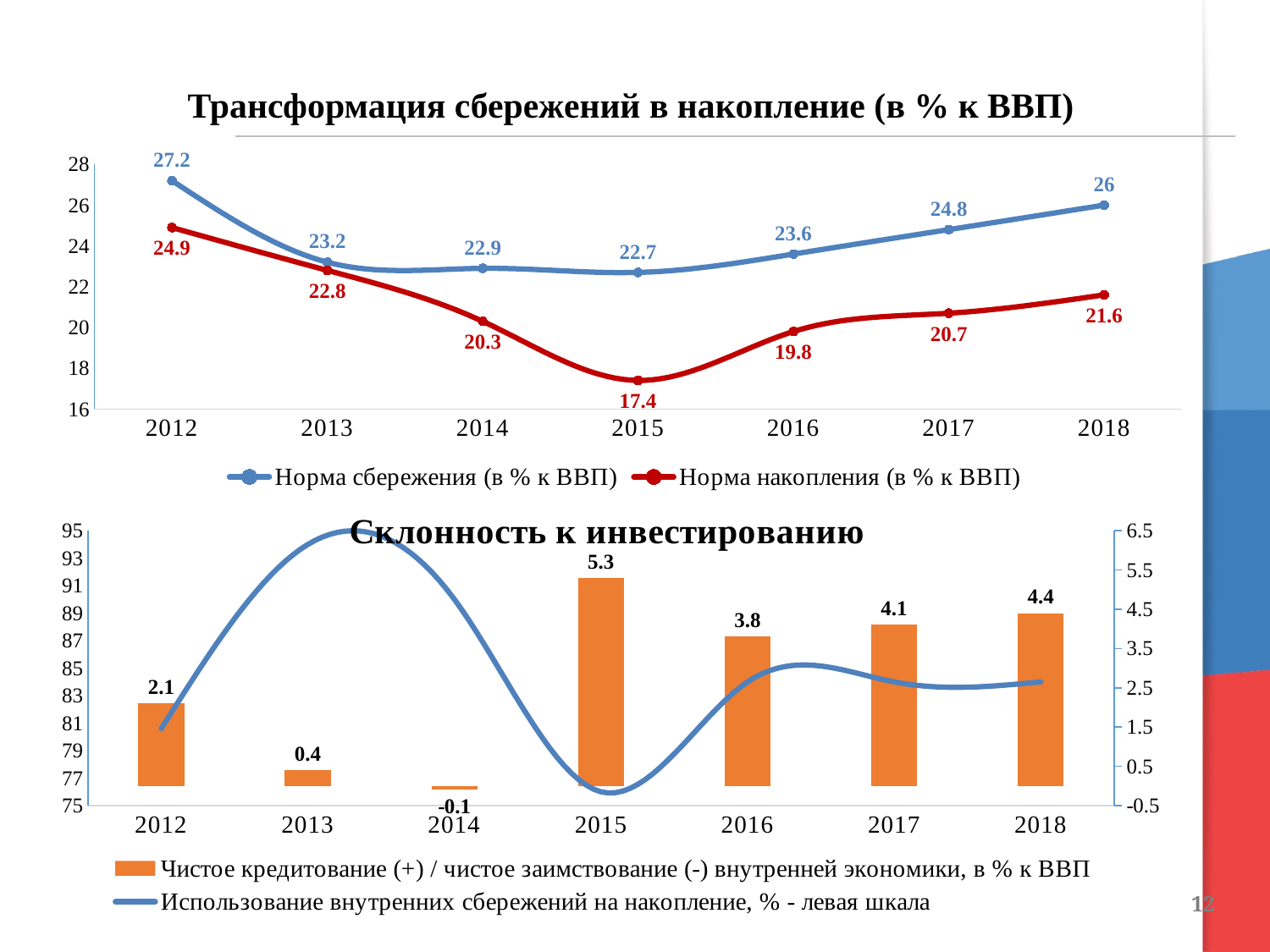
In the top chart 'Трансформация сбережений в накопление', what is the value of Норма сбережения in 2012? 27.2 In the top chart 'Трансформация сбережений в накопление', in which year is Норма накопления lowest? 2015 In the top chart 'Трансформация сбережений в накопление', what is the value of Норма накопления in 2015? 17.4 How many series does the legend of the top chart 'Трансформация сбережений в накопление' list? 2 In the bottom chart 'Склонность к инвестированию', is the value of the line (Использование внутренних сбережений на накопление) in 2015 greater or less than 80? less In the bottom chart 'Склонность к инвестированию', what is the value of the bar for 2015? 5.3 In the bottom chart 'Склонность к инвестированию', in which year is the bar value lowest? 2014 In the top chart 'Трансформация сбережений в накопление', what is the difference between Норма сбережения and Норма накопления in 2018? 4.4 What kind of chart is the top chart 'Трансформация сбережений в накопление'? Line chart In the top chart 'Трансформация сбережений в накопление', which series has the larger value in 2014? Норма сбережения (в % к ВВП) In the top chart 'Трансформация сбережений в накопление', does Норма сбережения rise or fall from 2015 to 2018? Rise In the top chart 'Трансформация сбережений в накопление', in which year is Норма сбережения highest? 2012